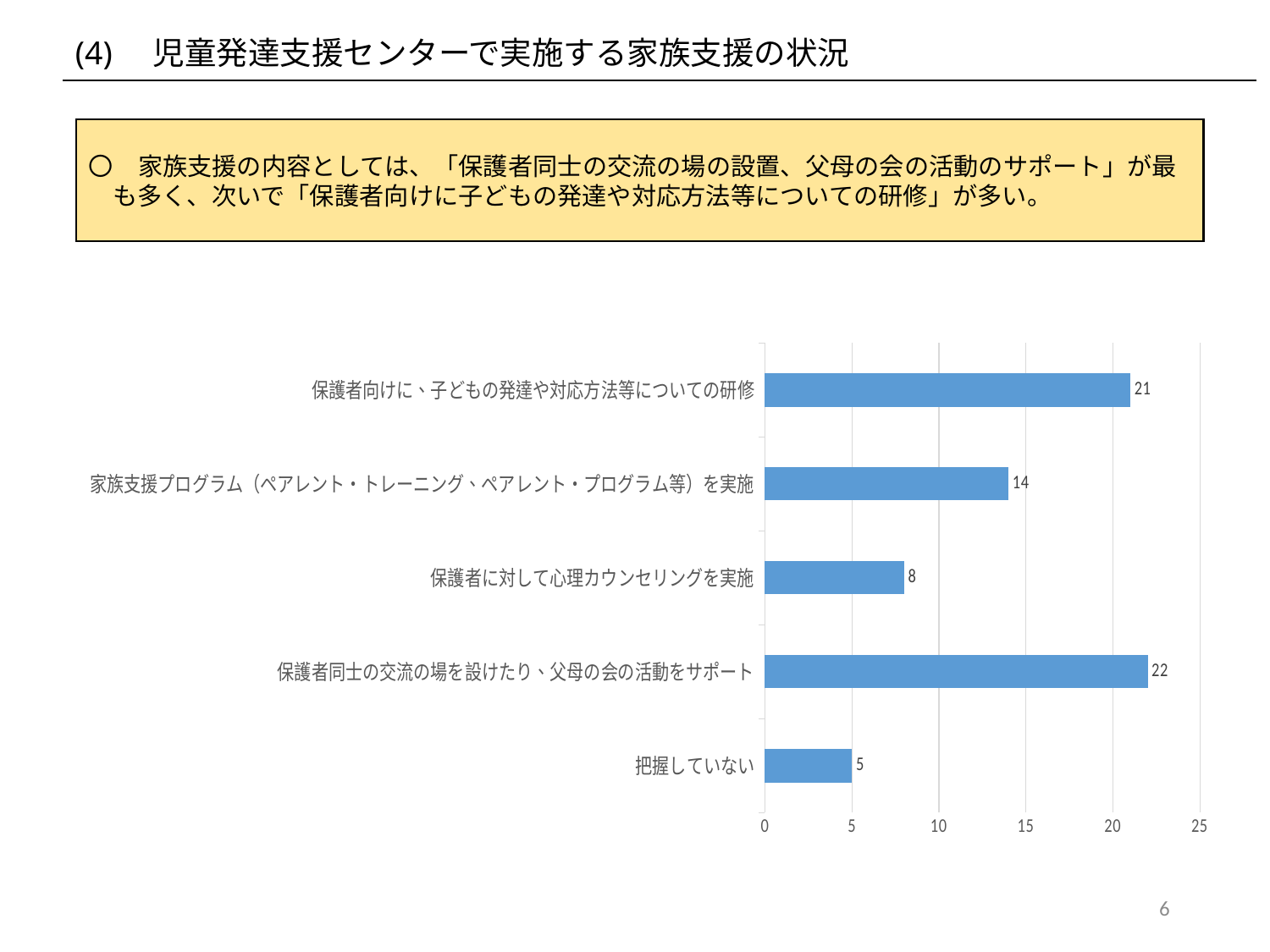
How many categories are shown in the chart? 5 Is the value for 保護者向けに、子どもの発達や対応方法等についての研修 greater or less than 20? greater What is the value for 保護者向けに、子どもの発達や対応方法等についての研修? 21 Which category has the highest value? 保護者同士の交流の場を設けたり、父母の会の活動をサポート What is the value for 家族支援プログラム（ペアレント・トレーニング、ペアレント・プログラム等）を実施? 14 What kind of chart is shown on the slide? bar chart What is the difference between the values for 保護者同士の交流の場を設けたり、父母の会の活動をサポート and 保護者向けに、子どもの発達や対応方法等についての研修? 1 Which category has the lowest value? 把握していない What is the value for 保護者に対して心理カウンセリングを実施? 8 What is the value for 把握していない? 5 What is the difference between the values for 家族支援プログラム（ペアレント・トレーニング、ペアレント・プログラム等）を実施 and 保護者に対して心理カウンセリングを実施? 6 Which is larger, the value for 家族支援プログラム（ペアレント・トレーニング、ペアレント・プログラム等）を実施 or the value for 保護者に対して心理カウンセリングを実施? 家族支援プログラム（ペアレント・トレーニング、ペアレント・プログラム等）を実施